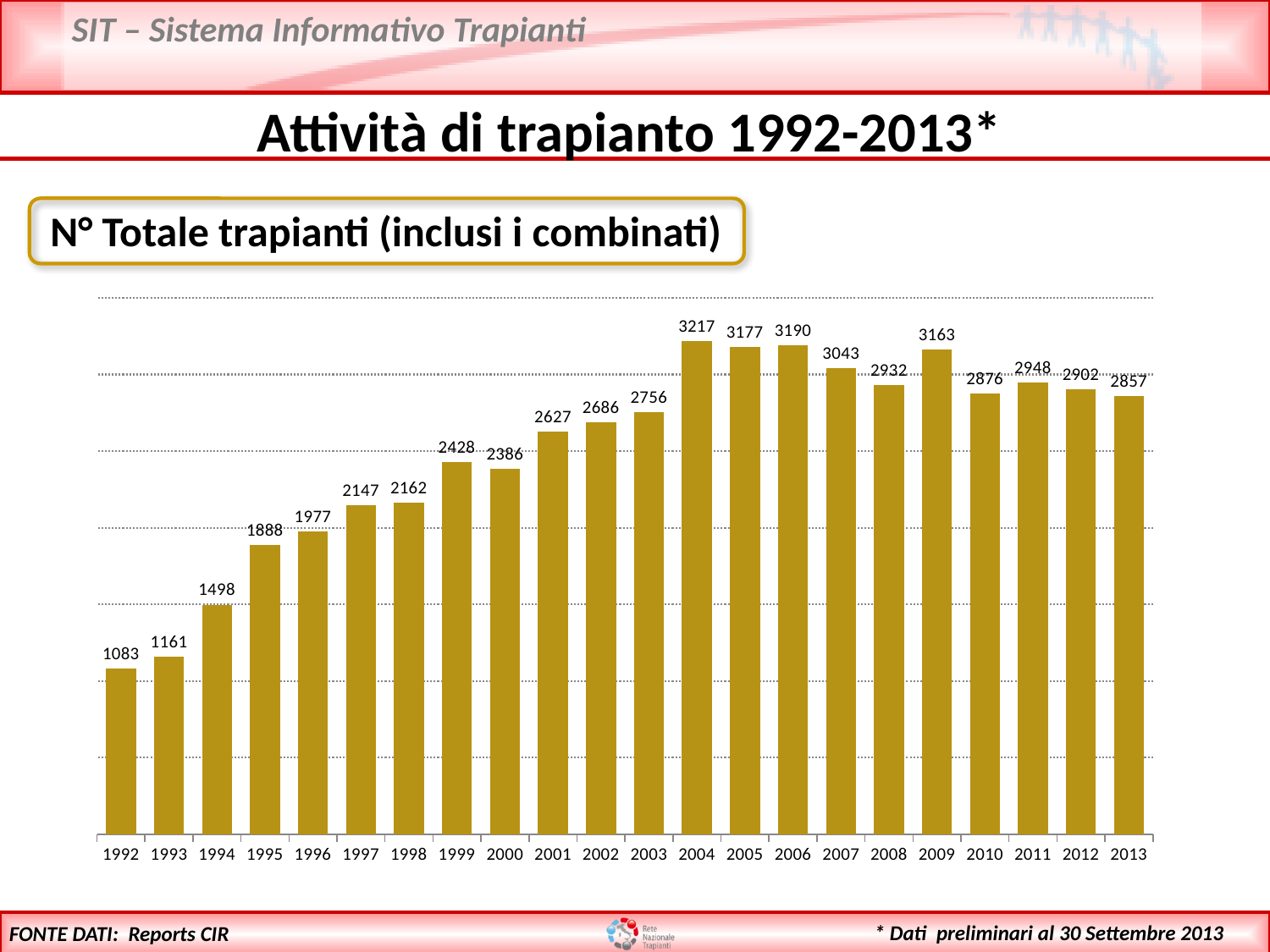
Do the values generally rise or fall from 1992 to 2004? Rise Which year has the highest number of total transplants? 2004 Which year has a larger value, 2005 or 2006? 2006 How many years are shown on the x axis? 22 What is the number of total transplants shown for 2004? 3217 What is the value for 2013? 2857 What is the difference between the values for 2004 and 2005? 40 What kind of chart is shown on the slide? Bar chart Which year has the lowest number of total transplants? 1992 What value is shown for 1992? 1083 What is the difference between the values for 2013 and 1992? 1774 What value is shown for 2000? 2386